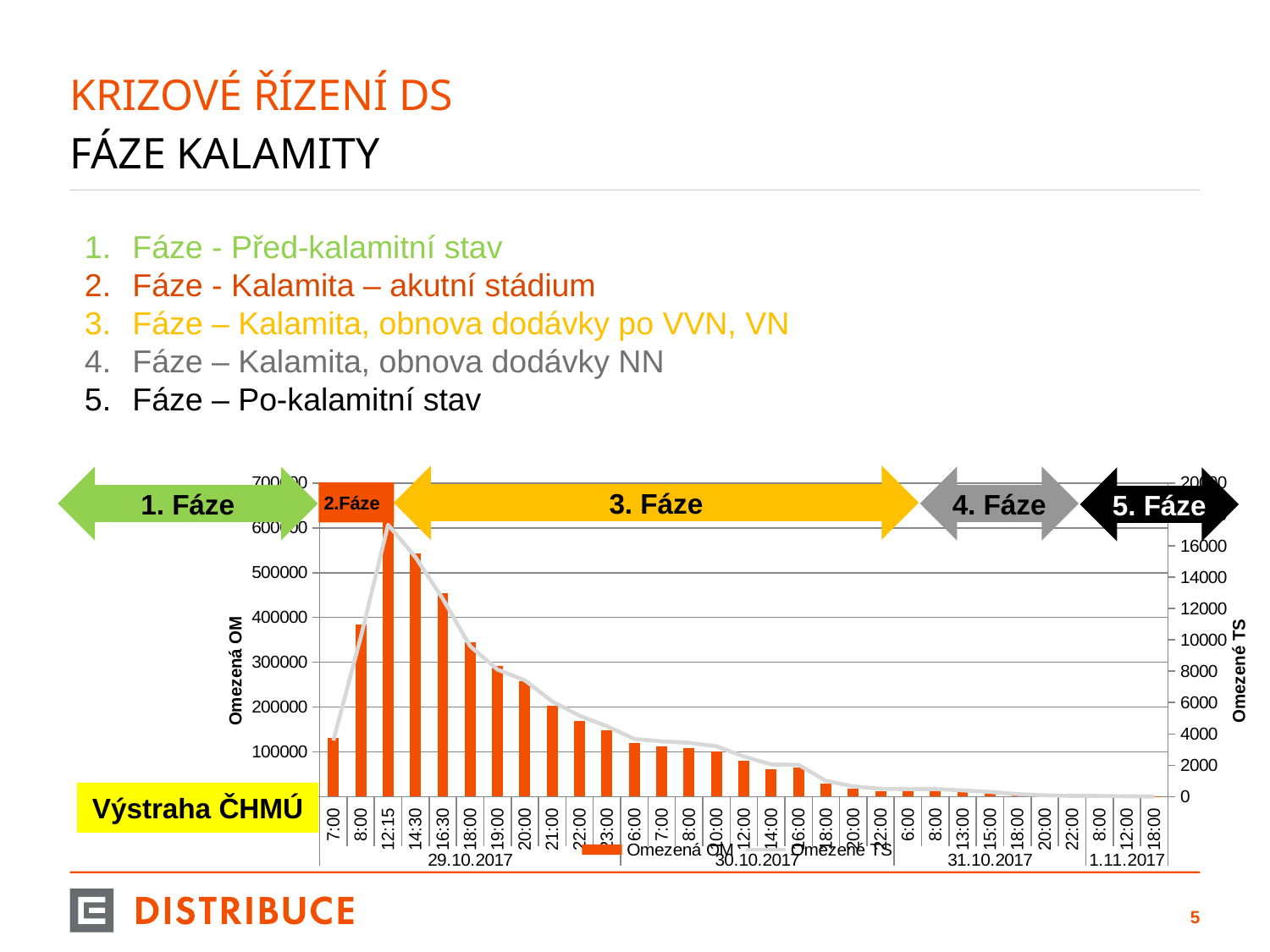
At which time on 29.10.2017 does the Omezená OM bar reach its highest value? 12:15 Which is larger, the Omezená OM value at 12:15 or at 14:30 on 29.10.2017? 12:15 After the peak at 12:15 on 29.10.2017, do the Omezená OM values rise or fall along the x axis? Fall Is the Omezená OM value at 7:00 on 29.10.2017 greater or less than 100000? greater Is the Omezená OM value at 22:00 on 29.10.2017 greater or less than 200000? less How many series does the chart legend list? 2 Is the Omezená OM value at 12:15 on 29.10.2017 greater or less than 500000? greater What kind of chart is shown on the slide? A combined bar and line chart How many dates are labelled along the x axis of the chart? 4 What is the title of the left vertical axis of the chart? Omezená OM Which series is drawn as bars in the chart? Omezená OM